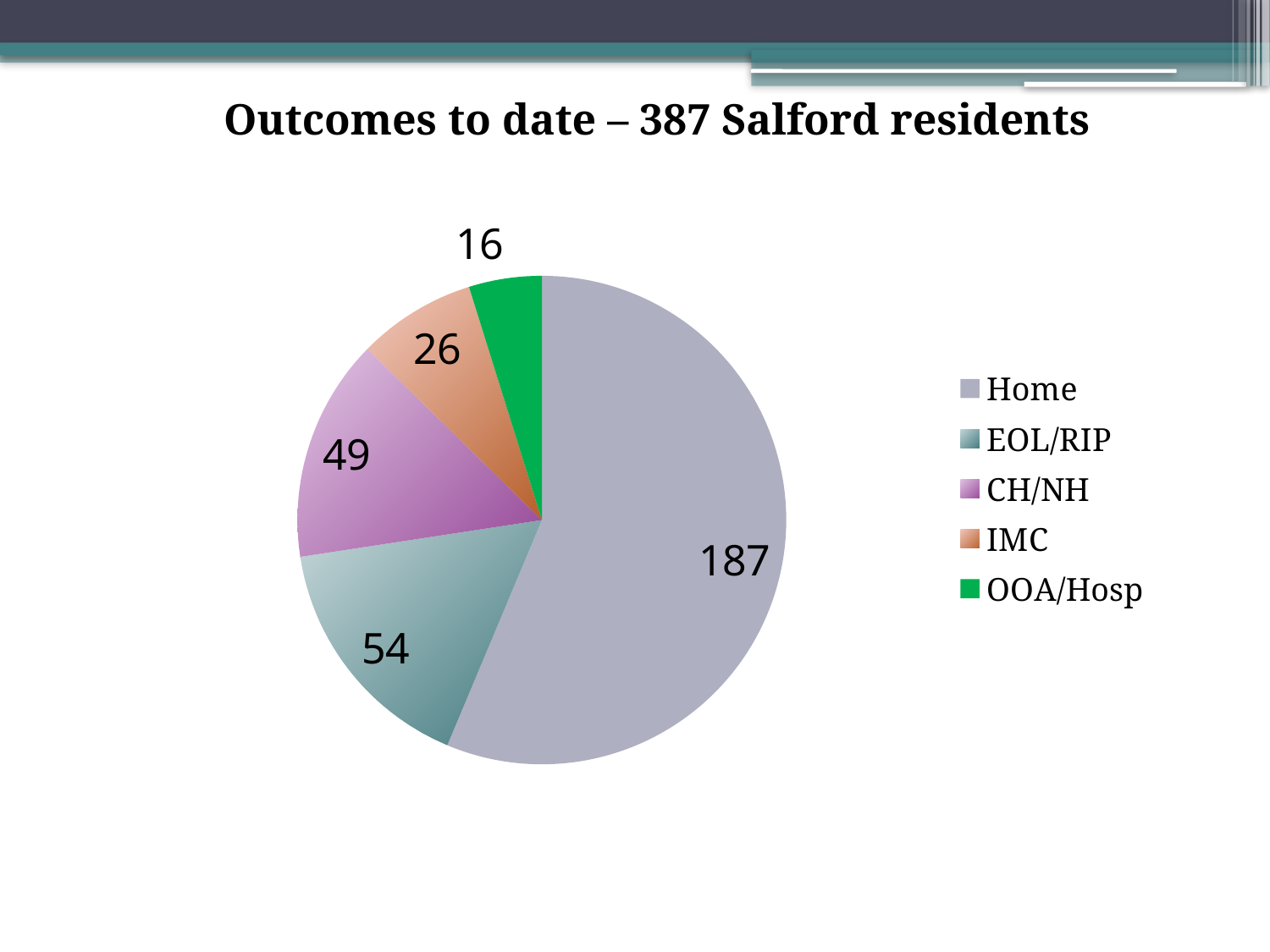
What is the value for OOA/Hosp? 16 What is the difference between the values for Home and EOL/RIP? 133 How many categories does the legend list? 5 What is the value for CH/NH? 49 Which category has the largest slice? Home Which category has the smallest slice? OOA/Hosp Which is larger, the value for CH/NH or the value for IMC? CH/NH What is the value for EOL/RIP? 54 What type of chart is shown on the slide? pie chart What is the value for Home? 187 What is the value for IMC? 26 What is the difference between the values for IMC and OOA/Hosp? 10